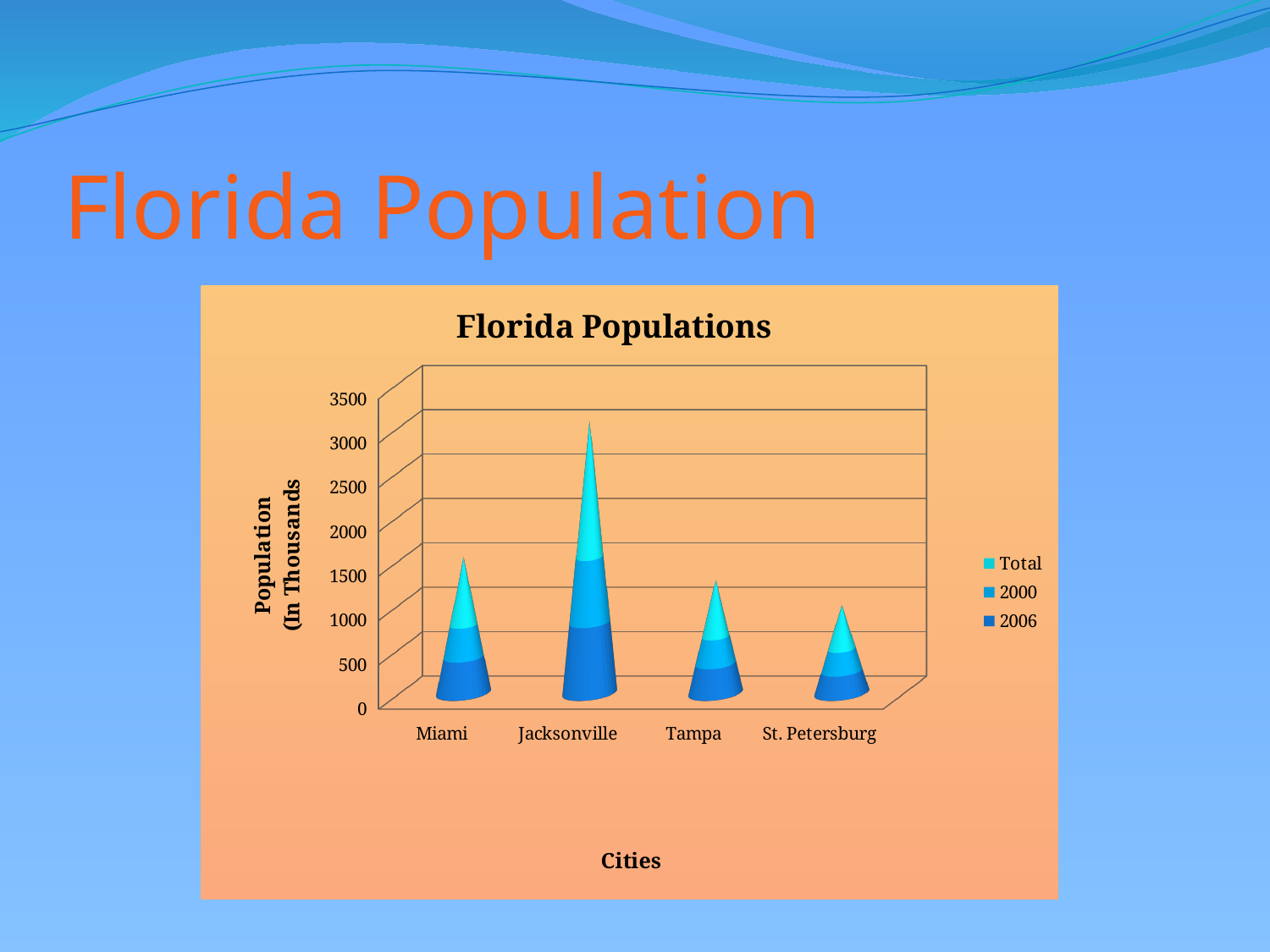
How many cities are shown on the x axis? 4 Which city has the shortest stacked bar? St. Petersburg Which city has the tallest stacked bar? Jacksonville Is the top of the stacked bar for St. Petersburg greater or less than 1500? less What is the label of the x axis? Cities What kind of chart is shown on the slide? bar chart What is the title of the chart? Florida Populations Is the stacked bar for Miami taller or shorter than the one for Tampa? taller Is the top of the stacked bar for Jacksonville greater or less than 2500? greater Is the stacked bar for Jacksonville taller or shorter than the one for Miami? taller How many series does the legend list? 3